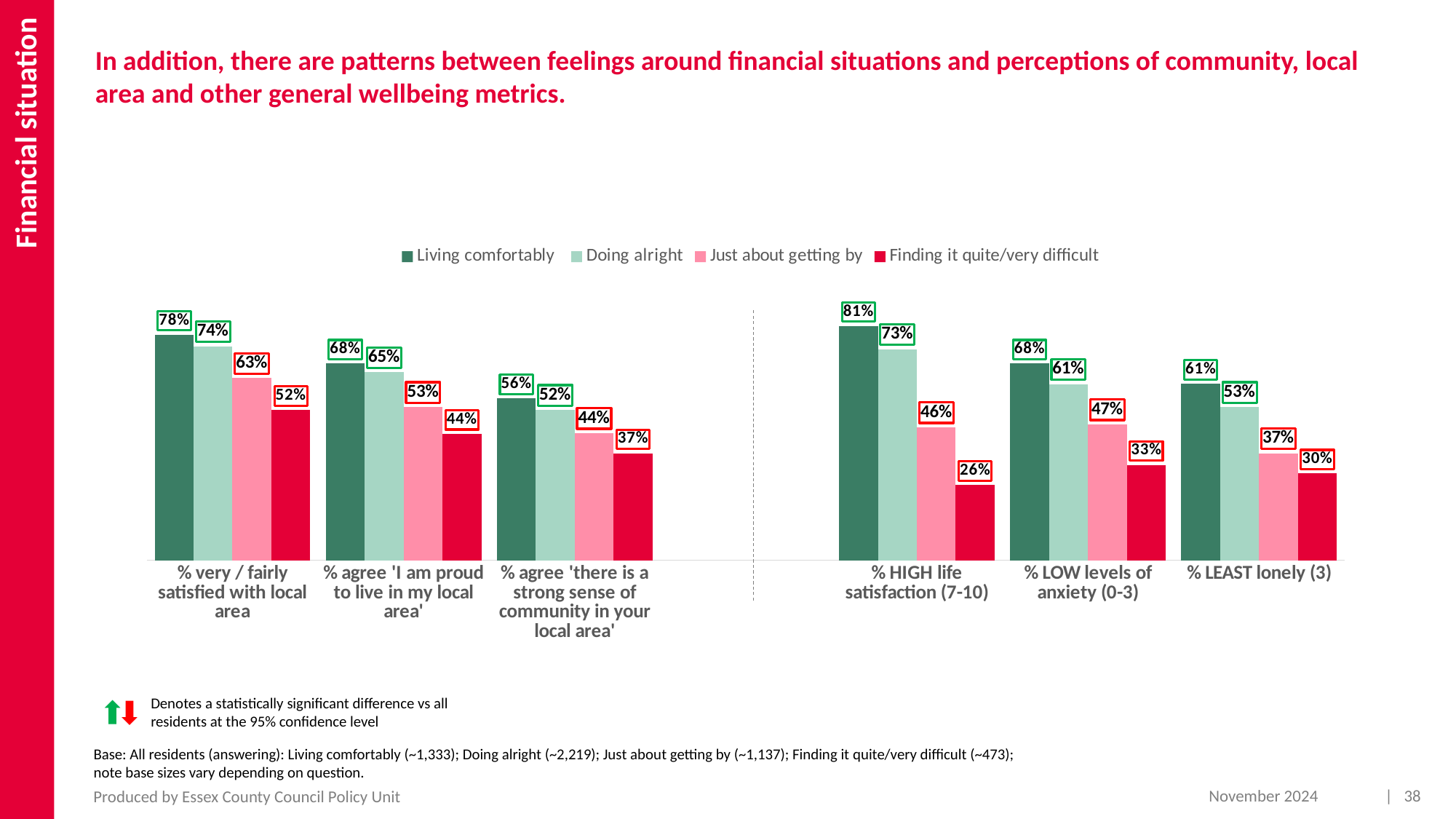
What is the value for 'Finding it quite/very difficult' in the '% very / fairly satisfied with local area' category? 52% Which is larger: 'Doing alright' for '% agree 'I am proud to live in my local area'' or 'Doing alright' for '% LEAST lonely (3)'? % agree 'I am proud to live in my local area' What is the value for 'Doing alright' in the '% LEAST lonely (3)' category? 53% Which legend entry is shown in the darkest red colour? Finding it quite/very difficult How many series does the legend list? 4 What is the value for 'Living comfortably' in the '% HIGH life satisfaction (7-10)' category? 81% What is the value for 'Just about getting by' in the '% LOW levels of anxiety (0-3)' category? 47% Which category has the lowest value for 'Finding it quite/very difficult'? % HIGH life satisfaction (7-10) Which category has the highest value for 'Living comfortably'? % HIGH life satisfaction (7-10) How many categories are shown on the x axis? 6 What kind of chart is shown on the slide? Bar chart What is the difference between 'Living comfortably' and 'Finding it quite/very difficult' in the '% HIGH life satisfaction (7-10)' category? 55 percentage points